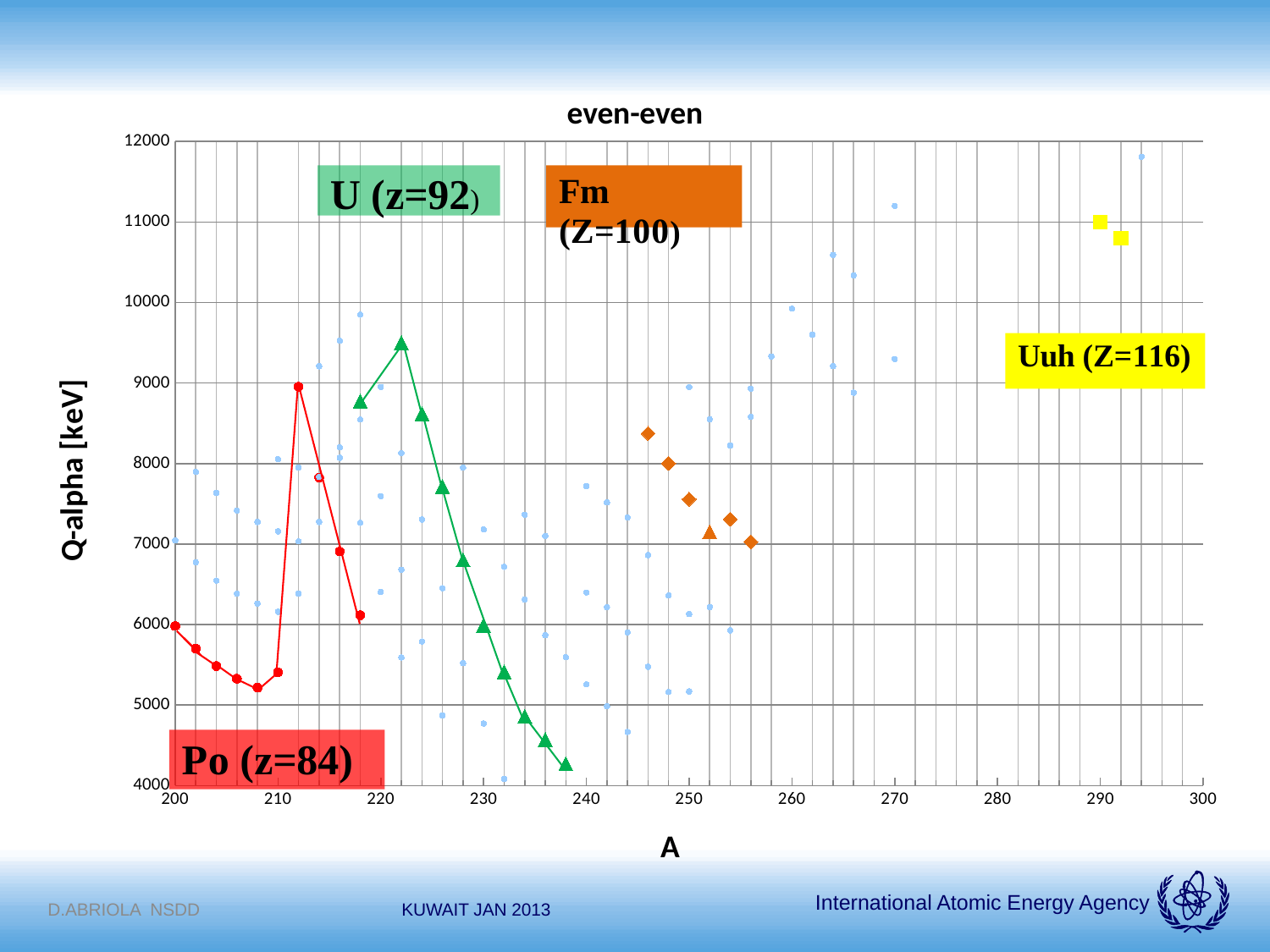
What is the title of the chart? even-even Is the Uuh (Z=116) value at A=292 greater or less than 10000? greater Is the Po (z=84) value at A=208 greater or less than 6000? less What is the label of the vertical axis? Q-alpha [keV] What kind of chart is shown on the slide? scatter chart Do the U (z=92) values rise or fall as A increases from 222 to 238? fall Is the U (z=92) value at A=238 greater or less than 5000? less Which is larger: the U (z=92) peak value at A=222 or the Po (z=84) peak value at A=212? U (z=92) at A=222 Which of the labelled series reaches the highest Q-alpha value? Uuh (Z=116) Do the Fm (Z=100) values rise or fall as A increases from 246 to 256? fall